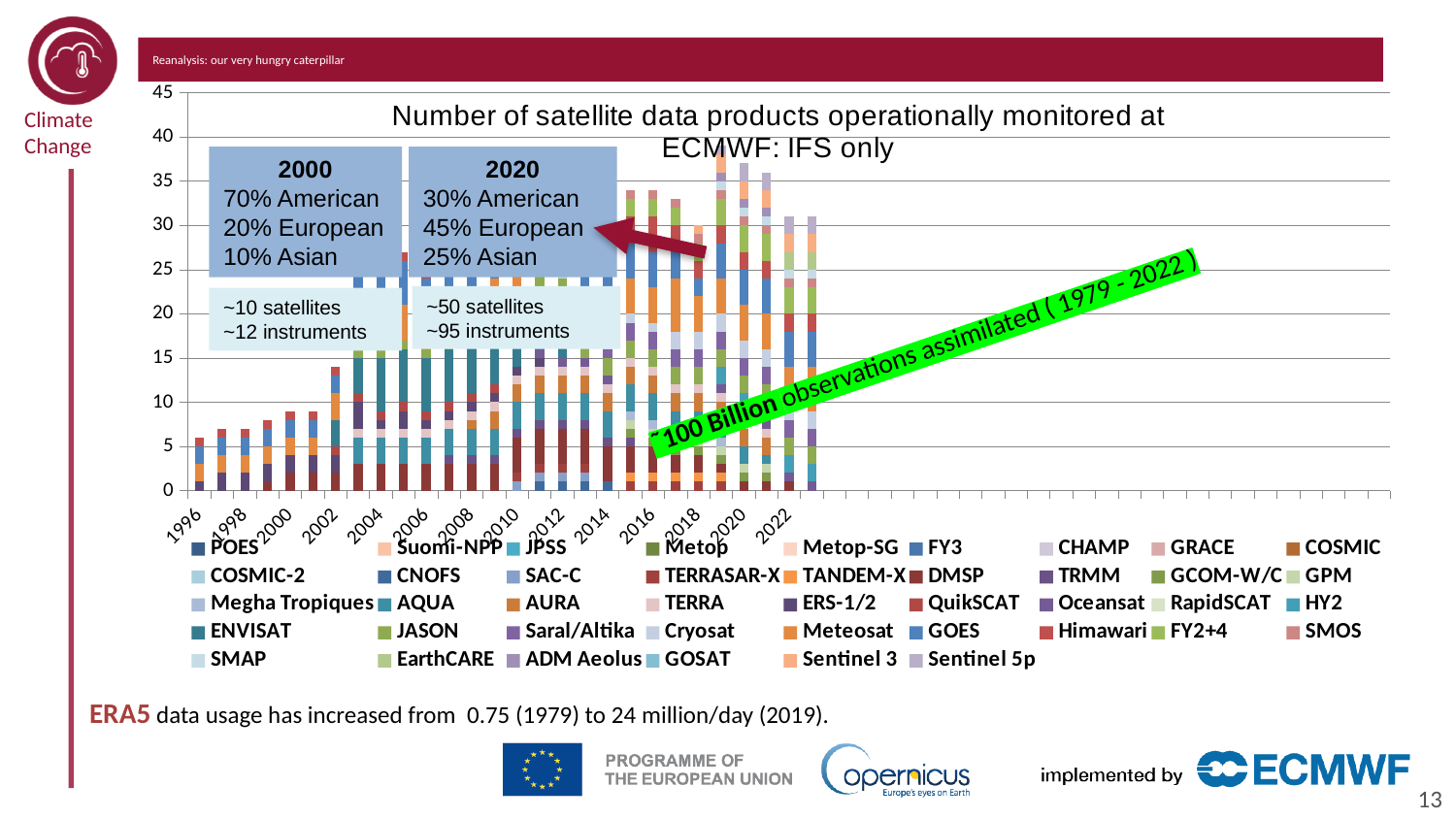
What is the maximum value shown on the vertical axis? 45 Is the total for 2020 greater or less than 35? greater Is the total for 2004 greater or less than 20? less Overall, do the bar totals rise or fall from 1996 to 2020? Rise Which year has the tallest bar in the chart? 2020 Which year has the taller bar, 2002 or 2012? 2012 Which year has the taller bar, 1996 or 2020? 2020 Is the total for 2016 greater or less than 30? greater What is the title of the chart? Number of satellite data products operationally monitored at ECMWF: IFS only How many series does the chart legend list? 42 What kind of chart is shown on the slide? Stacked bar chart